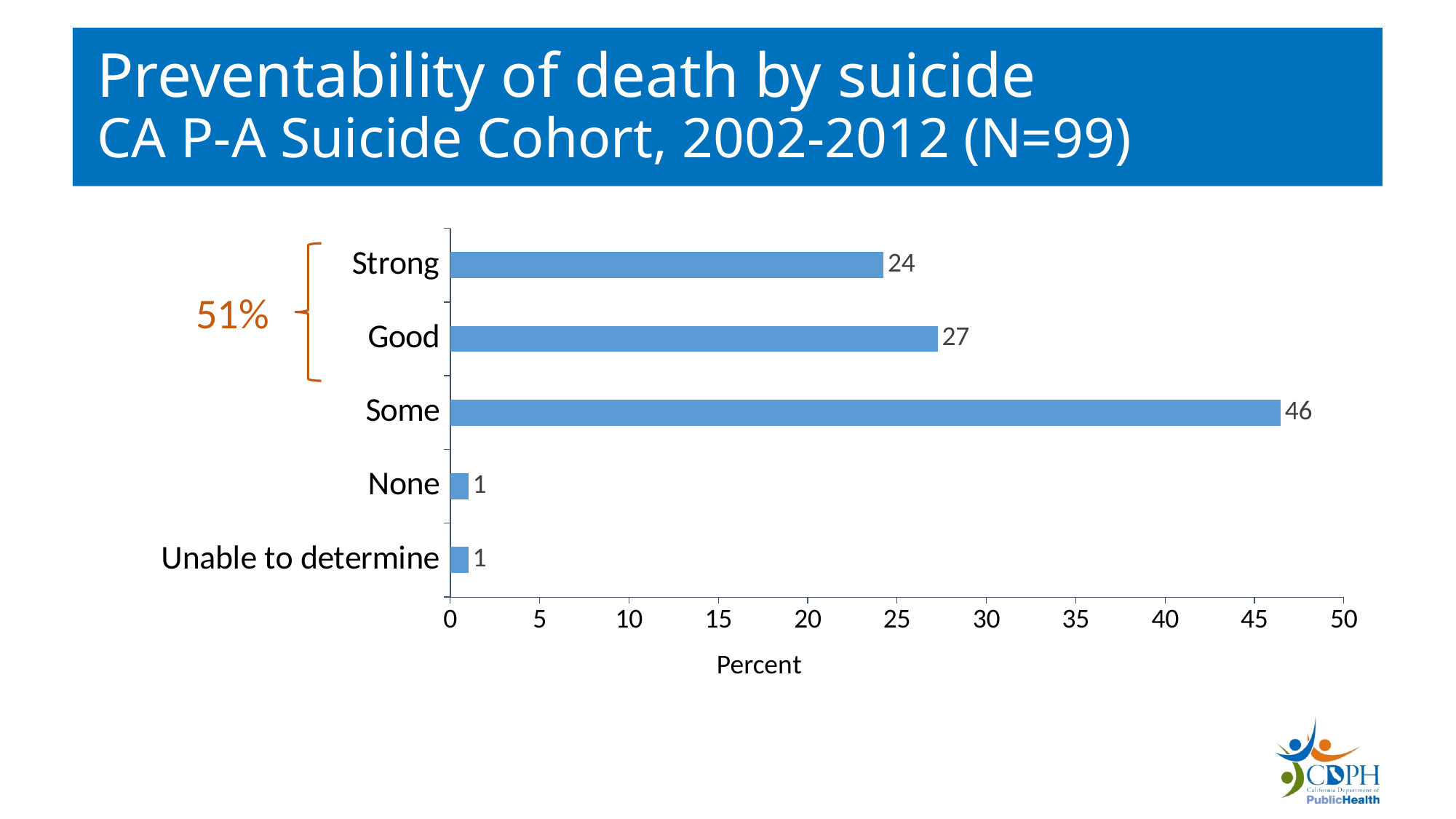
What is the value for Unable to determine? 1 What is the value for Strong? 24 What is the value for Some? 46 Which category has the highest value? Some What is the difference between the values for Some and Good? 19 Which is larger, the value for Strong or the value for Good? Good What is the label on the horizontal axis? Percent What is the value for Good? 27 Is the value for Some greater or less than 40? greater How many categories are shown on the chart? 5 What kind of chart is shown on the slide? bar chart What is the difference between the values for Good and Strong? 3